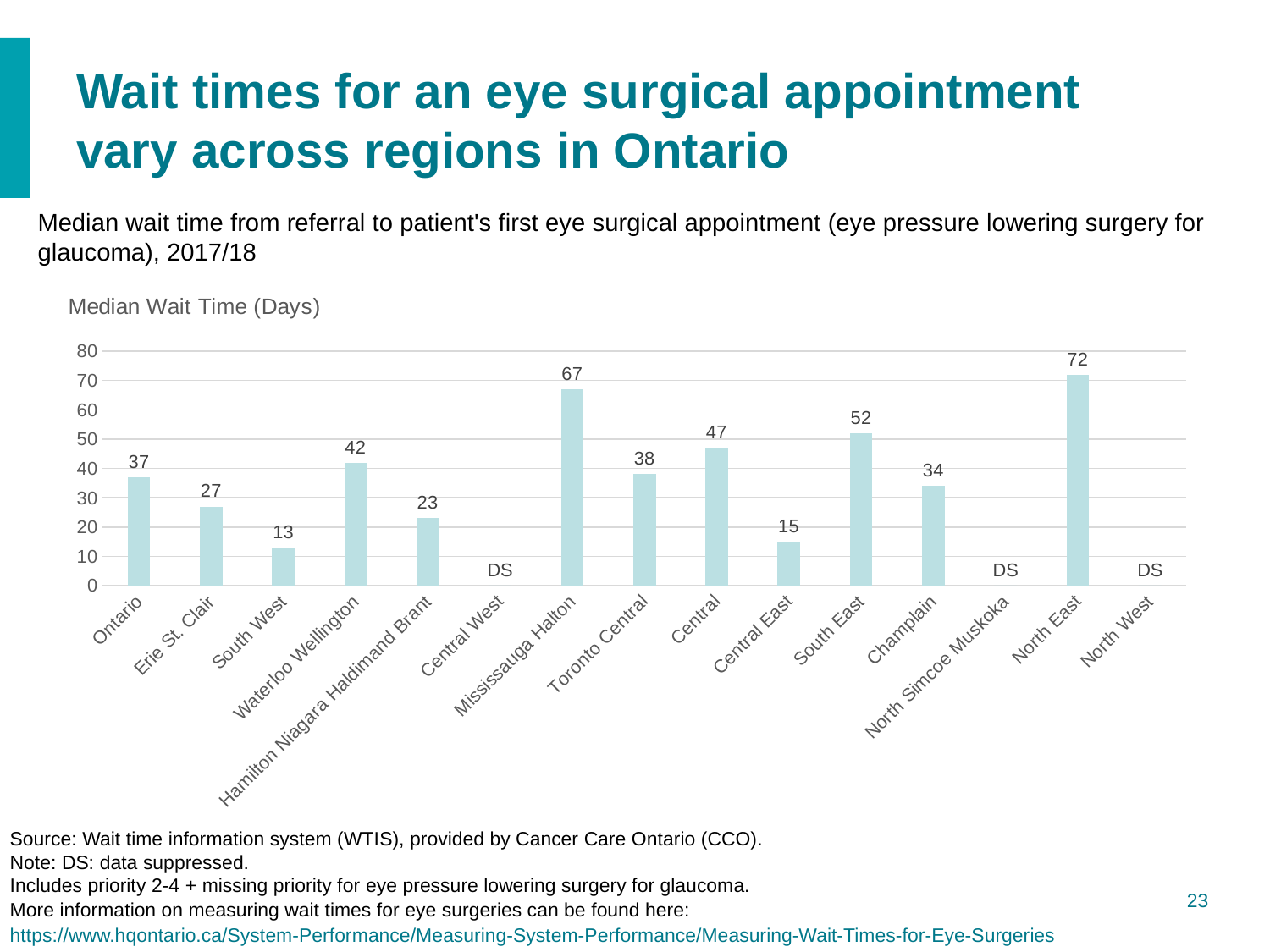
What is the difference in median wait time between North East and Central East? 57 Among regions with a plotted value, which has the lowest median wait time? South West What is the median wait time in days for Mississauga Halton? 67 How many regions are listed on the x axis of the chart? 15 Which has a longer median wait time, Toronto Central or Waterloo Wellington? Waterloo Wellington What type of chart is shown on the slide? bar chart What is the median wait time in days for Ontario? 37 How many regions are marked DS (data suppressed) in the chart? 3 What is the label on the vertical axis of the chart? Median Wait Time (Days) What is the median wait time in days for Champlain? 34 Which region has the highest median wait time? North East Is the median wait time for South East greater or less than 50? greater